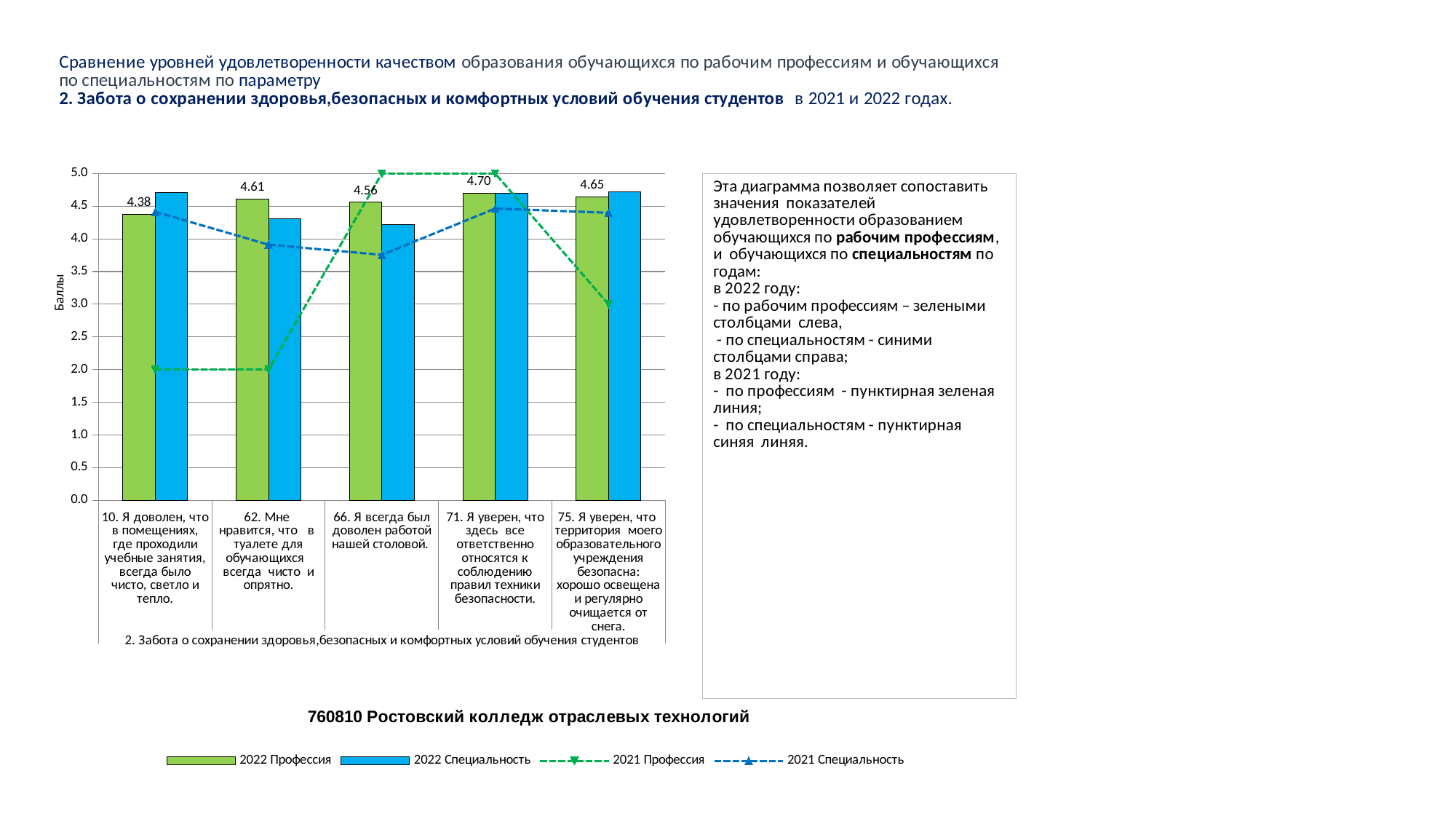
How many survey items (categories) are shown on the x axis? 5 Is the 2022 Специальность value for item 66 greater or less than 4.5? less How many series does the legend list? 4 Which item has the lowest 2022 Профессия value? 10. Я доволен, что в помещениях, где проходили учебные занятия, всегда было чисто, светло и тепло What is the value of the 2022 Профессия bar for item 71 (Я уверен, что здесь все ответственно относятся к соблюдению правил техники безопасности)? 4.70 Which item has the highest 2022 Профессия value? 71. Я уверен, что здесь все ответственно относятся к соблюдению правил техники безопасности What is the value of the 2022 Профессия bar for item 62 (Мне нравится, что в туалете для обучающихся всегда чисто и опрятно)? 4.61 What is the value of the 2022 Профессия bar for item 10 (Я доволен, что в помещениях, где проходили учебные занятия, всегда было чисто, светло и тепло)? 4.38 Is the 2021 Профессия value for item 62 greater or less than 3.0? less For the 2022 Профессия series, which is larger: item 62 or item 66? Item 62 What is the label of the vertical axis? Баллы What is the difference between the 2022 Профессия values for item 71 and item 10? 0.32